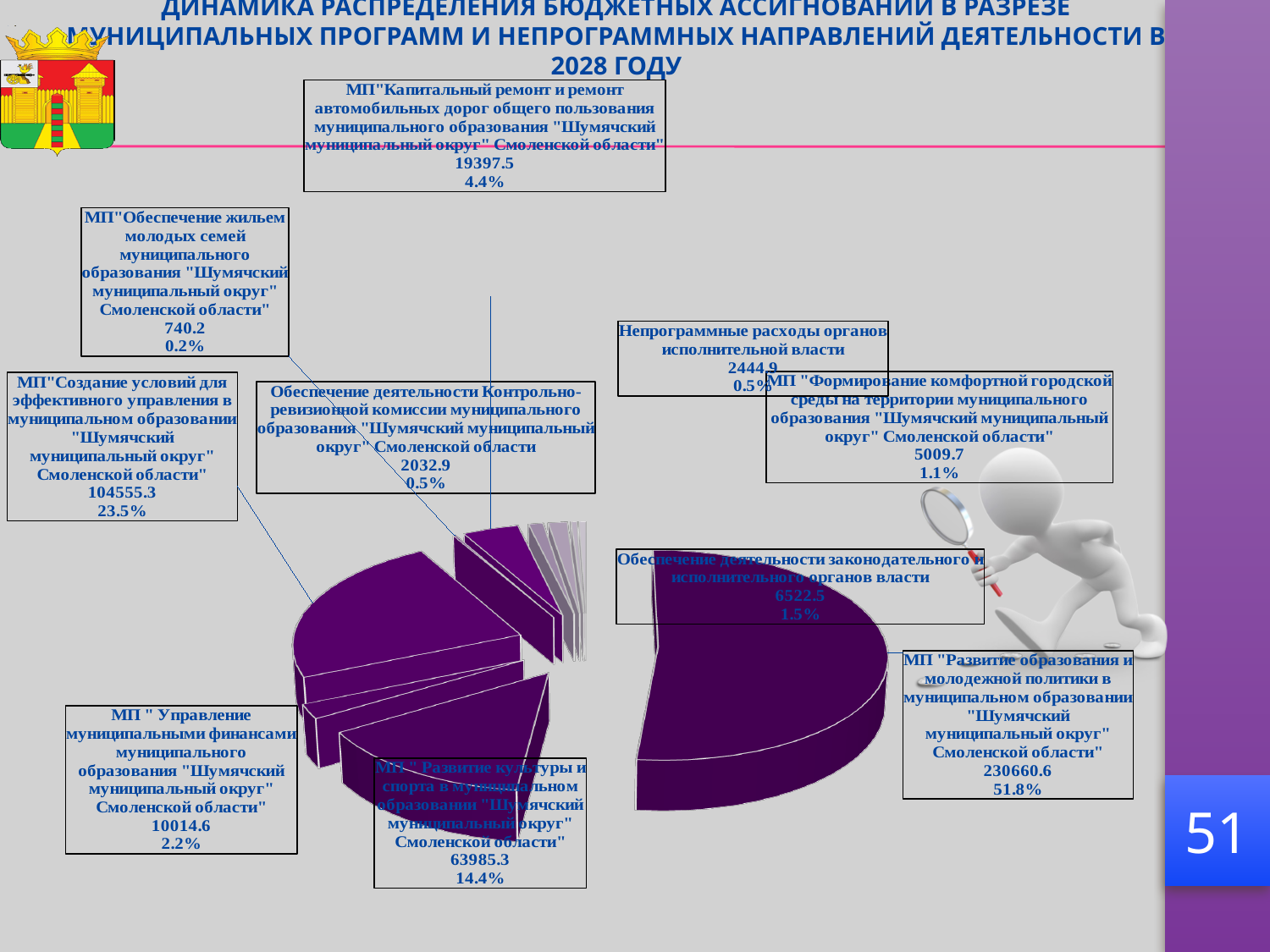
Which category has the smallest value? МП "Обеспечение жильем молодых семей" What percentage is shown for МП "Капитальный ремонт и ремонт автомобильных дорог"? 4.4% Which category has the largest share of the pie? МП "Развитие образования и молодежной политики" What value is shown for МП "Развитие образования и молодежной политики"? 230660.6 What value is shown for Непрограммные расходы органов исполнительной власти? 2444.9 What year does the slide title say the budget allocation distribution refers to? 2028 What percentage share is shown for МП "Развитие культуры и спорта"? 14.4% How many categories are shown in the pie chart? 10 What kind of chart is shown on the slide? Pie chart Which is larger: the value for МП "Управление муниципальными финансами" or for МП "Капитальный ремонт и ремонт автомобильных дорог"? МП "Капитальный ремонт и ремонт автомобильных дорог" What is the difference between the values for МП "Развитие образования и молодежной политики" and МП "Создание условий для эффективного управления"? 126105.3 What value is shown for МП "Создание условий для эффективного управления"? 104555.3